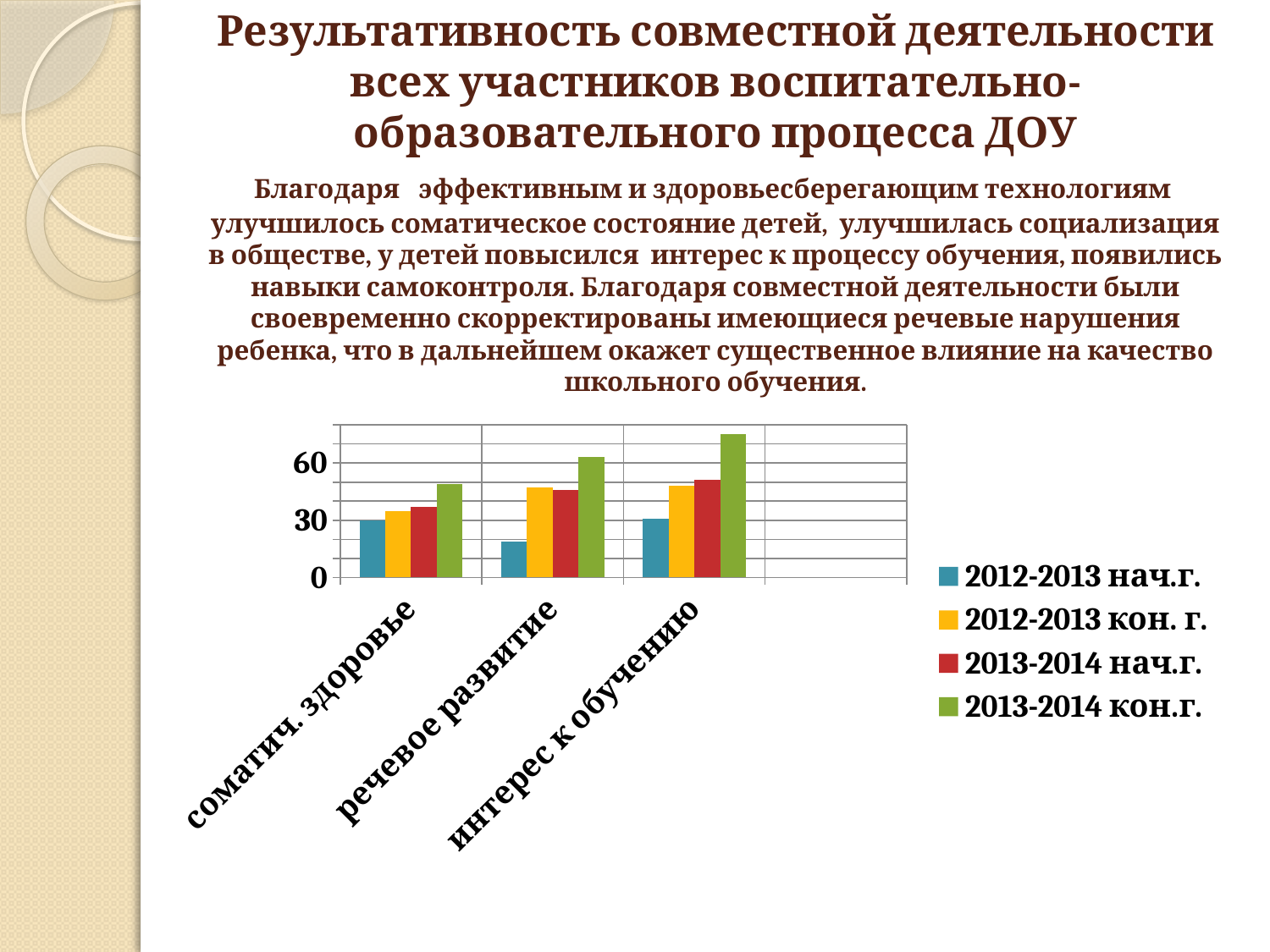
In the category интерес к обучению, which is larger: the 2012-2013 нач.г. bar or the 2013-2014 кон.г. bar? 2013-2014 кон.г. Which category has the highest bar for the 2013-2014 кон.г. series? интерес к обучению How many categories are shown on the x axis of the chart? 3 How many series does the chart legend list? 4 Is the value for 2013-2014 кон.г. in the category речевое развитие greater or less than 30? greater In the category соматич. здоровье, do the bars rise or fall from the 2012-2013 нач.г. series to the 2013-2014 кон.г. series? rise Which category is listed first on the x axis of the chart? соматич. здоровье Which series is shown in green in the chart legend? 2013-2014 кон.г. What kind of chart is shown on the slide? bar chart Is the value for 2012-2013 нач.г. in the category речевое развитие greater or less than 30? less Which category has the lowest bar for the 2012-2013 нач.г. series? речевое развитие Is the value for 2013-2014 кон.г. in the category интерес к обучению greater or less than 60? greater